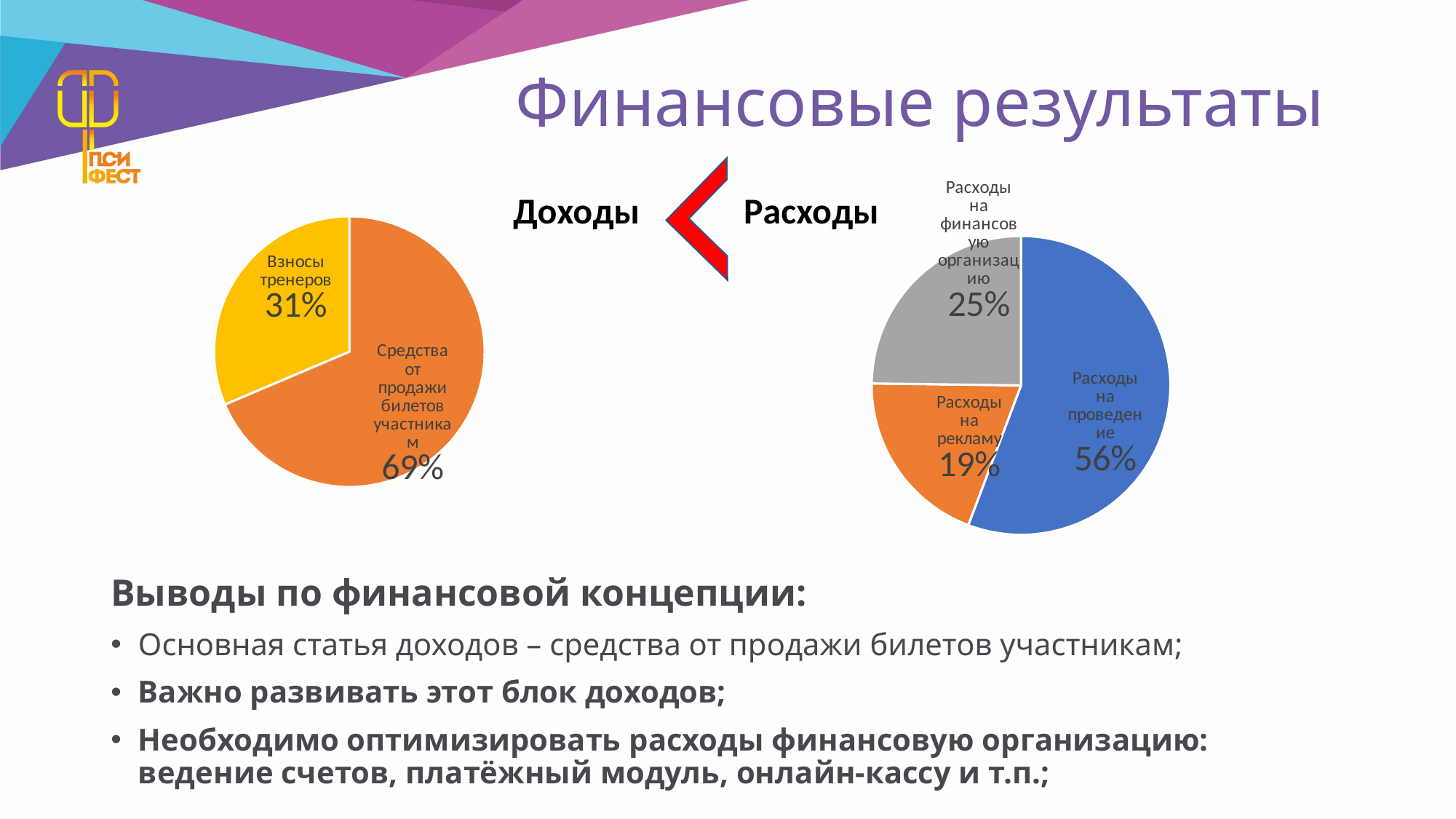
How many slices does the "Расходы" pie chart have? 3 In the "Доходы" pie chart, which slice is the largest? Средства от продажи билетов участникам In the "Расходы" pie chart, what share is "Расходы на рекламу"? 19% In the "Расходы" pie chart, what share is "Расходы на проведение"? 56% In the "Расходы" pie chart, what share is "Расходы на финансовую организацию"? 25% How many slices does the "Доходы" pie chart have? 2 In the "Расходы" pie chart, what is the difference between "Расходы на проведение" and "Расходы на финансовую организацию"? 31% In the "Расходы" pie chart, which slice is the smallest? Расходы на рекламу What type of chart is the "Доходы" chart on the left? pie chart In the "Расходы" pie chart, what colour is the "Расходы на проведение" slice? blue